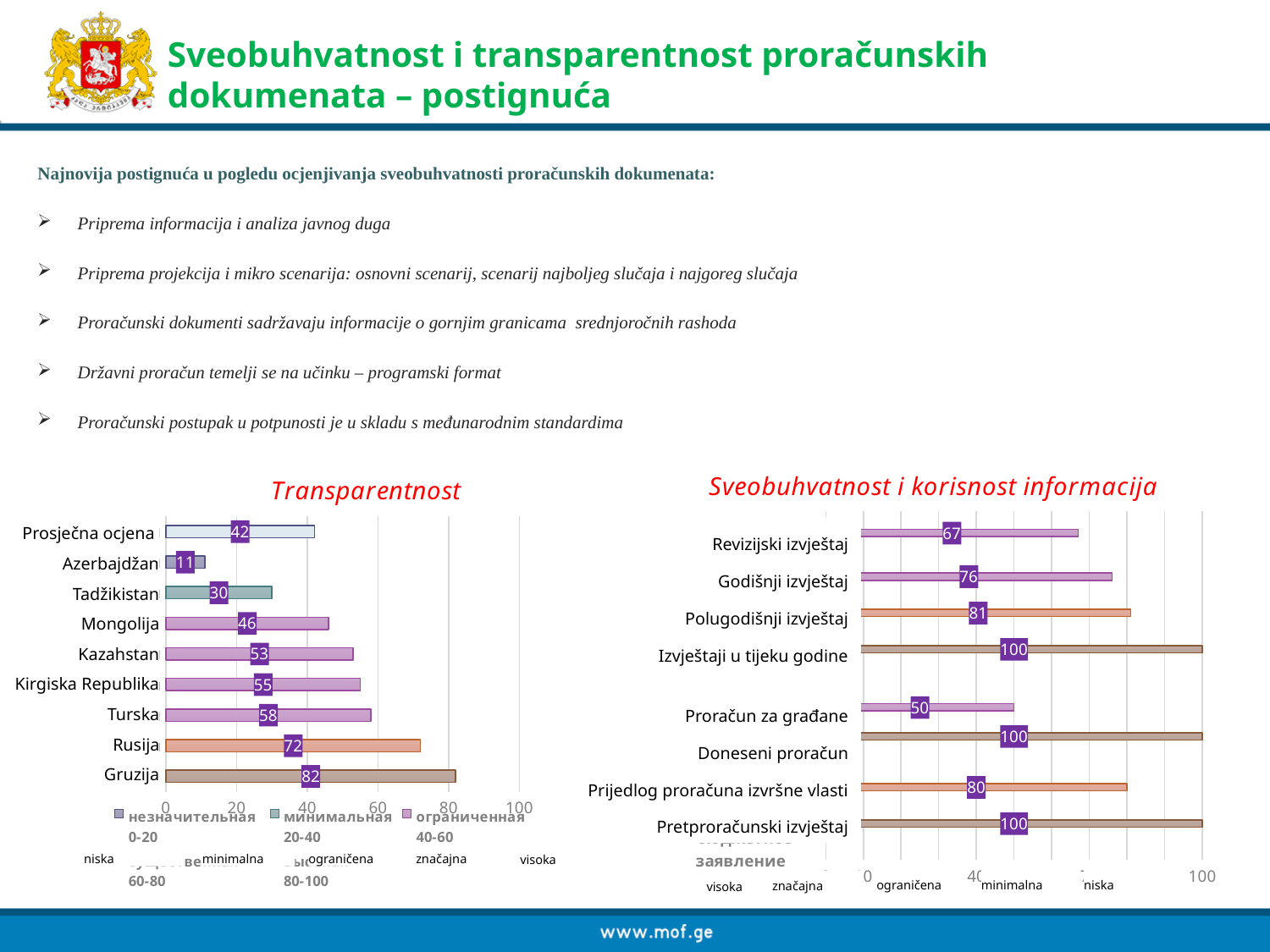
In the Transparentnost chart, what is the value for Prosječna ocjena? 42 In the Sveobuhvatnost i korisnost informacija chart, what is the value for Polugodišnji izvještaj? 81 In the Transparentnost chart, what is the difference between the values for Rusija and Turska? 14 In the Transparentnost chart, which is larger, the value for Kazahstan or the value for Mongolija? Kazahstan In the Transparentnost chart, which category has the lowest value? Azerbajdžan How many categories are shown in the Transparentnost chart? 9 In the Transparentnost chart, which country has the highest value? Gruzija In the Sveobuhvatnost i korisnost informacija chart, what is the value for Proračun za građane? 50 In the Sveobuhvatnost i korisnost informacija chart, what is the difference between the values for Godišnji izvještaj and Revizijski izvještaj? 9 What kind of chart is the Sveobuhvatnost i korisnost informacija chart? bar chart In the Transparentnost chart, what is the value for Azerbajdžan? 11 In the Transparentnost chart, what is the value for Gruzija? 82